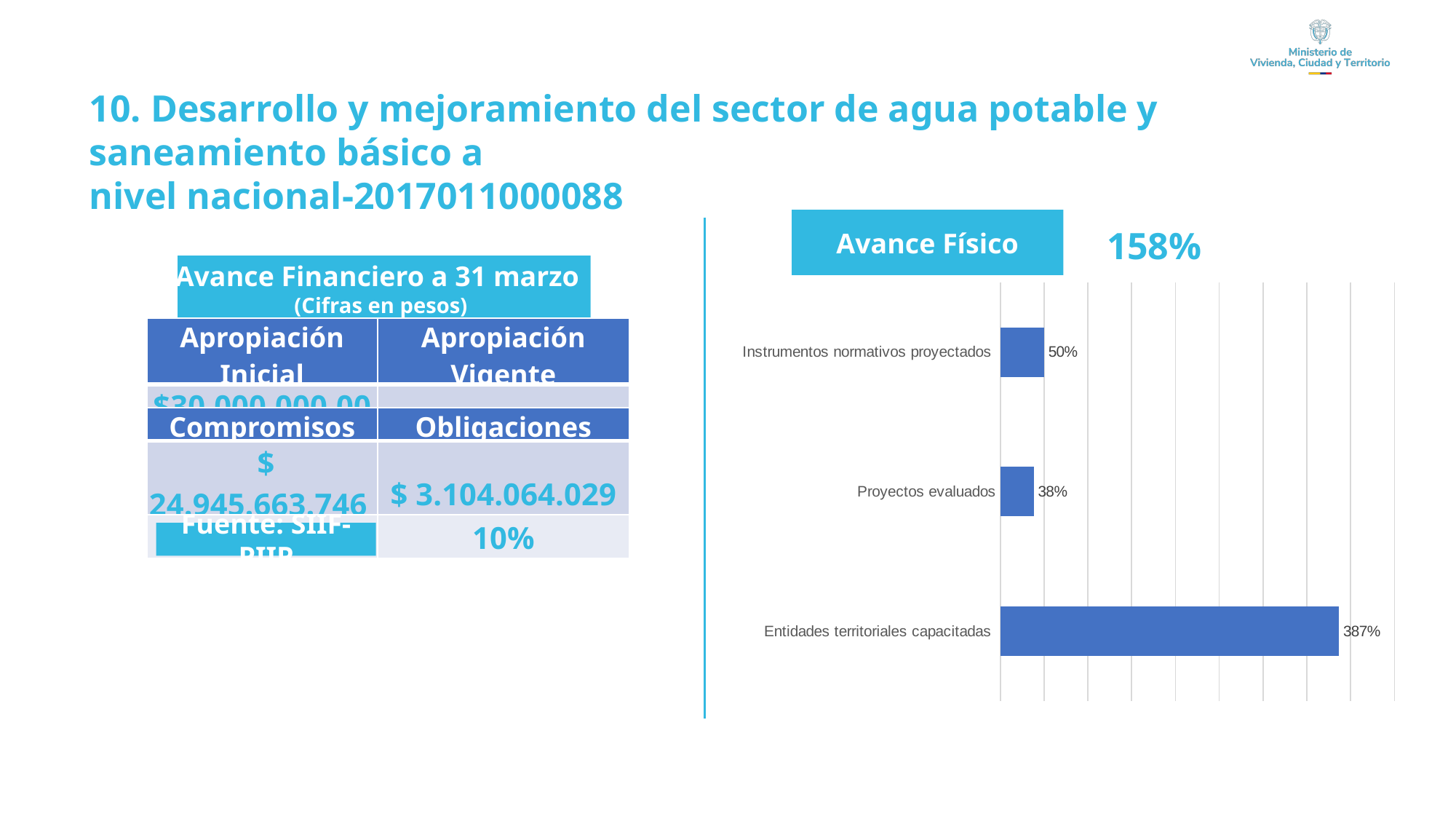
What is the value for Entidades territoriales capacitadas? 387% What kind of chart is shown on the slide? bar chart Which category has the highest value? Entidades territoriales capacitadas What is the value for Instrumentos normativos proyectados? 50% Which category has the lowest value? Proyectos evaluados What is the difference between the values for Entidades territoriales capacitadas and Instrumentos normativos proyectados? 337% What is the difference between the values for Instrumentos normativos proyectados and Proyectos evaluados? 12% What is the value for Proyectos evaluados? 38% What is the title shown above the chart? Avance Físico What overall percentage is displayed next to the chart title? 158% Which is larger, the value for Instrumentos normativos proyectados or the value for Proyectos evaluados? Instrumentos normativos proyectados How many categories are shown in the chart? 3